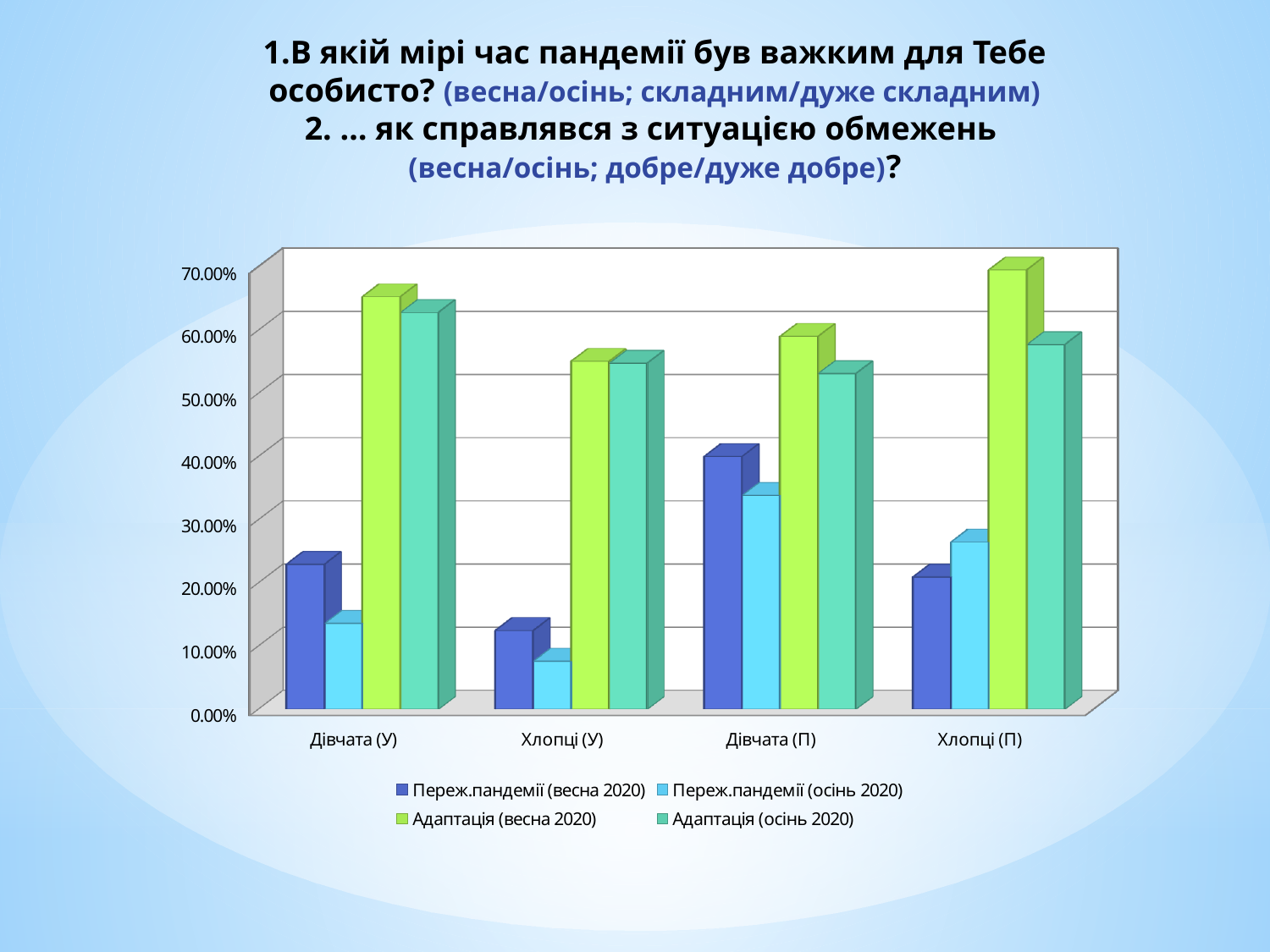
Is the value of Адаптація (весна 2020) for Дівчата (У) greater or less than 60.00%? greater Which category has the highest value for the series Переж.пандемії (весна 2020)? Дівчата (П) Which category has the highest value for the series Адаптація (весна 2020)? Хлопці (П) Is the value of Переж.пандемії (осінь 2020) for Хлопці (У) greater or less than 20.00%? less Is the value of Переж.пандемії (весна 2020) for Дівчата (П) greater or less than 30.00%? greater Which category has the lowest value for the series Переж.пандемії (осінь 2020)? Хлопці (У) What kind of chart is shown on the slide? Bar chart For Дівчата (У), which is larger: Переж.пандемії (весна 2020) or Переж.пандемії (осінь 2020)? Переж.пандемії (весна 2020) What colour represents the series Адаптація (весна 2020) in the legend? Light green How many series does the chart's legend list? 4 How many categories are shown on the x axis of the chart? 4